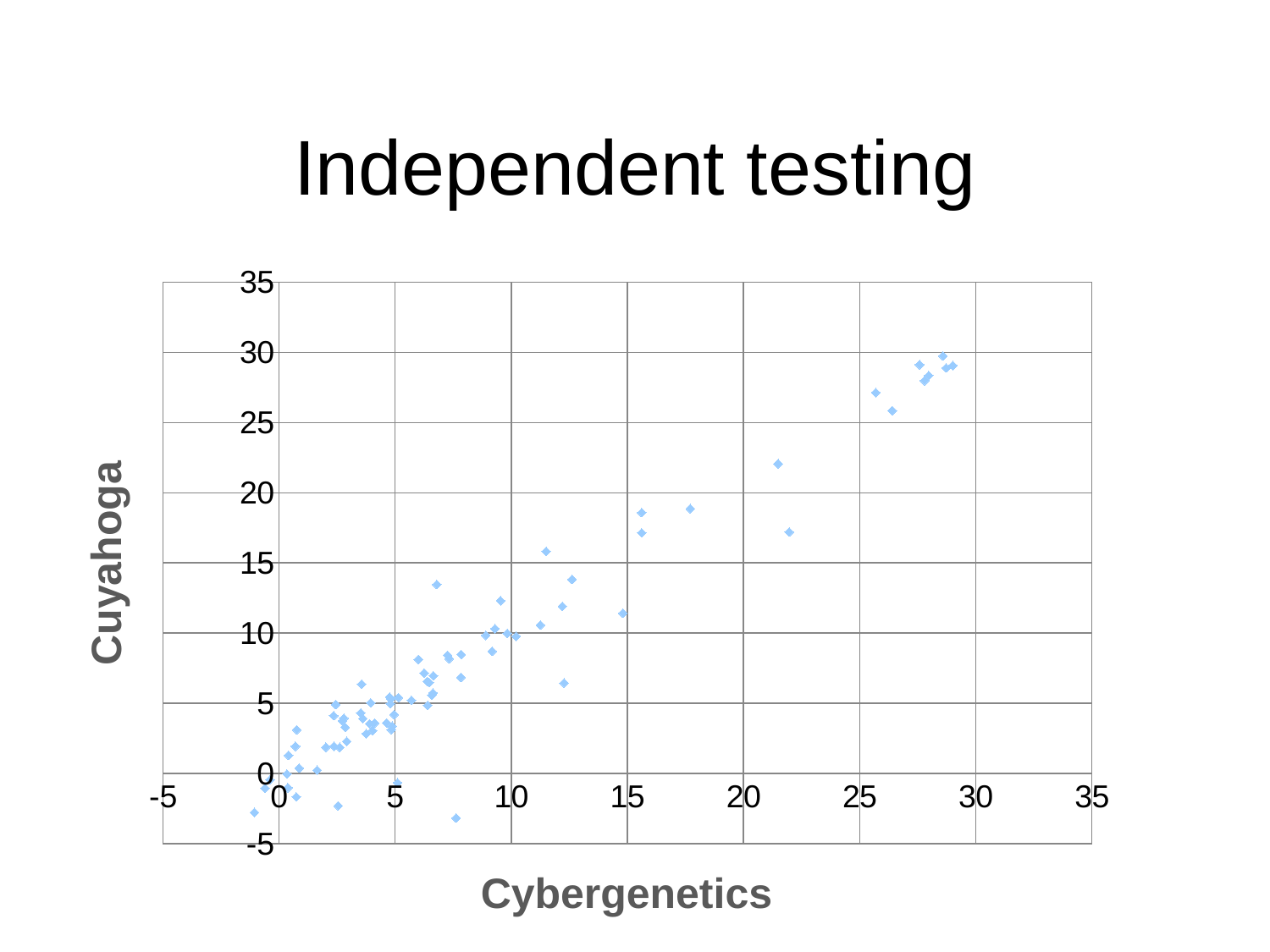
What kind of chart is shown on the slide? scatter chart Is the largest Cybergenetics value plotted greater or less than 25? greater What label is shown on the horizontal axis of the chart? Cybergenetics What is the title of the slide containing the chart? Independent testing Is the highest Cuyahoga value plotted greater or less than 25? greater As the Cybergenetics value increases along the x axis, do the Cuyahoga values generally rise or fall? rise Is the lowest Cuyahoga value plotted greater or less than 0? less